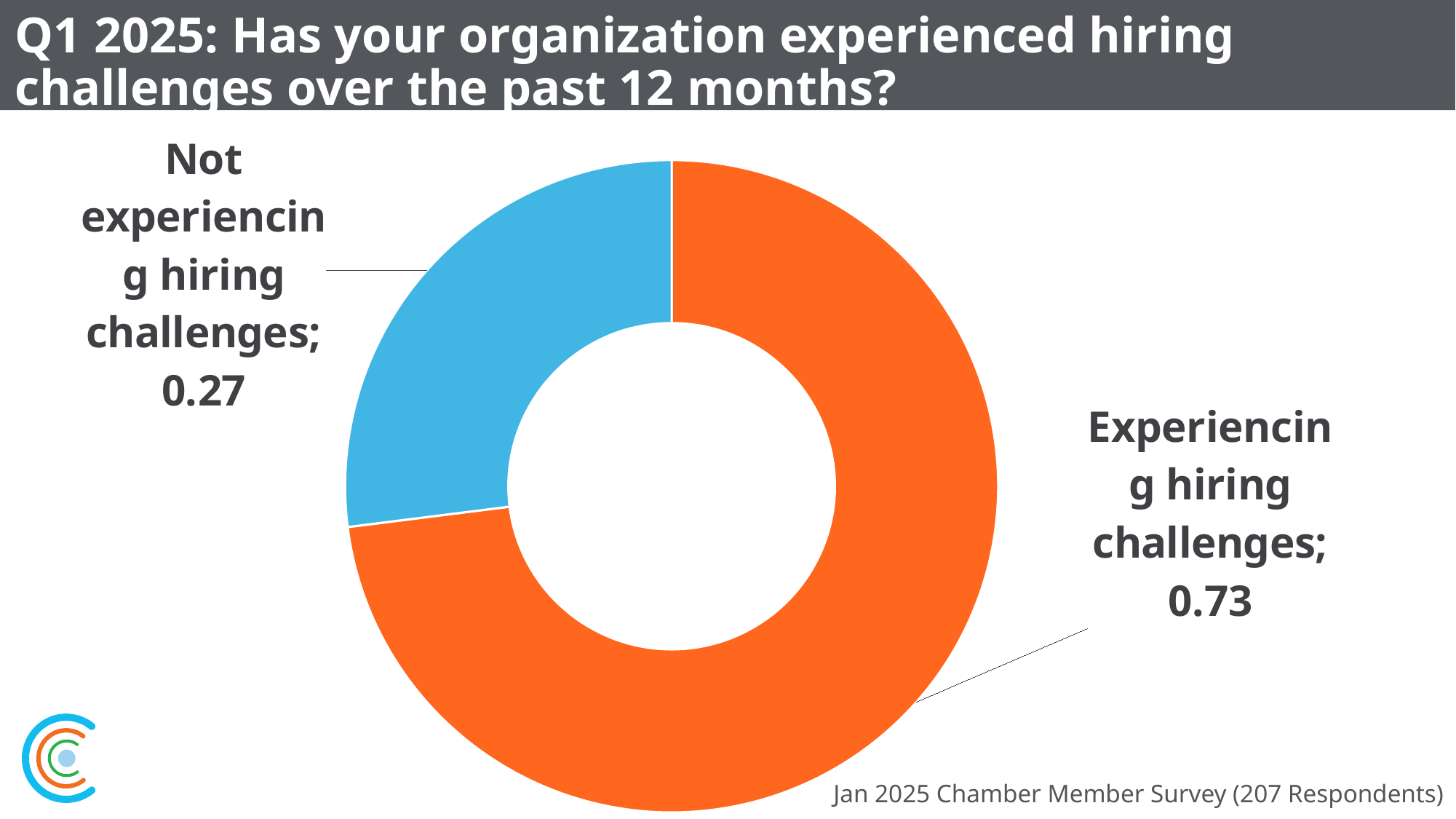
Which category has the smallest share of the chart? Not experiencing hiring challenges How many categories are shown in the chart? 2 What value is shown for the 'Experiencing hiring challenges' slice? 0.73 What kind of chart is shown on the slide? Pie chart (doughnut) What colour is the 'Experiencing hiring challenges' slice? Orange What is the difference between the values for 'Experiencing hiring challenges' and 'Not experiencing hiring challenges'? 0.46 What is the total of the two values shown on the chart? 1.00 Which category has the largest share of the chart? Experiencing hiring challenges What value is shown for the 'Not experiencing hiring challenges' slice? 0.27 How many respondents does the source note say the survey had? 207 Which is larger: the value for 'Experiencing hiring challenges' or 'Not experiencing hiring challenges'? Experiencing hiring challenges